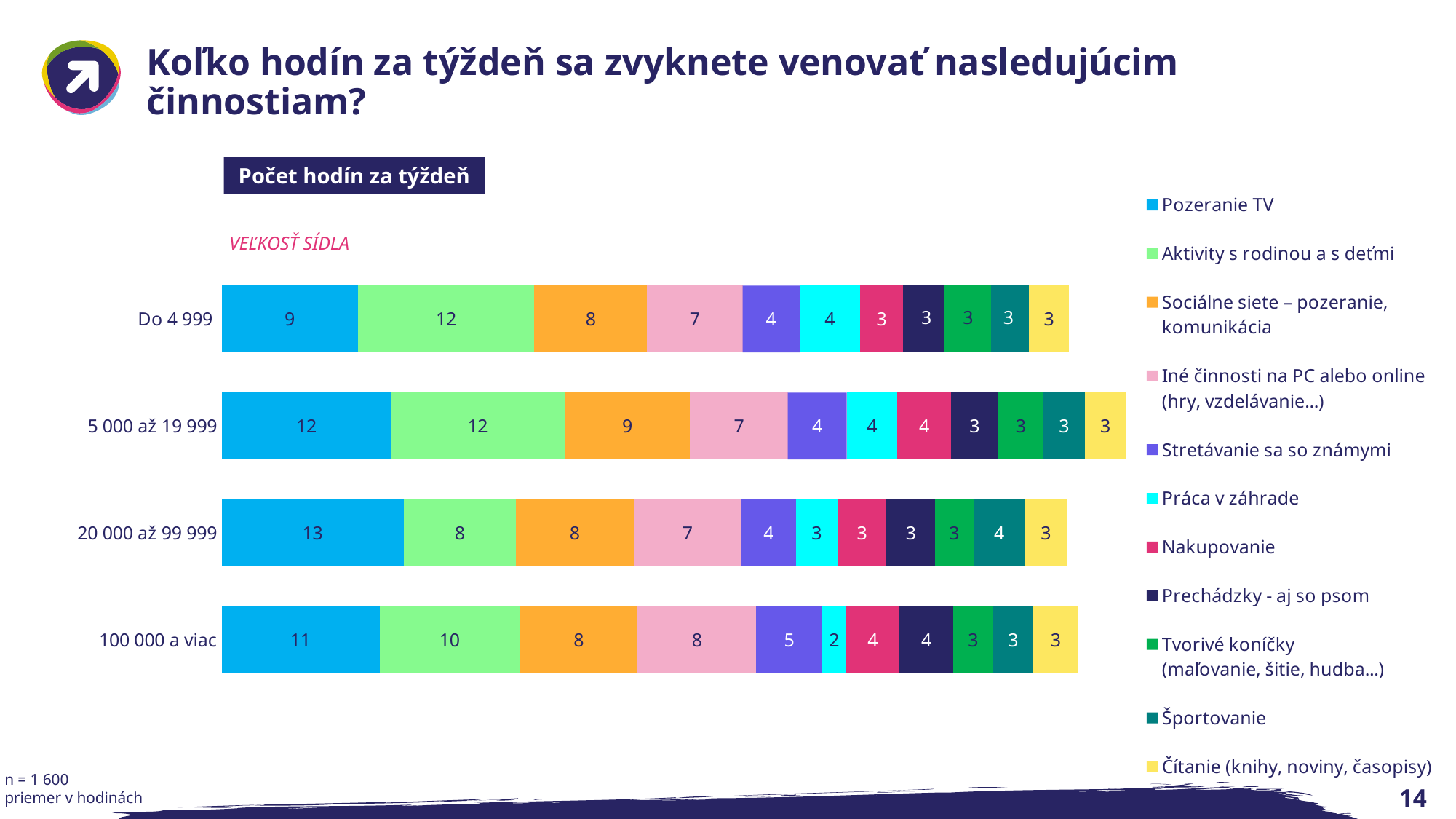
What is the title shown in the box above the chart? Počet hodín za týždeň What is the value for Pozeranie TV in the 20 000 až 99 999 category? 13 What is the total of the stacked bar for 5 000 až 19 999? 64 What is the value for Aktivity s rodinou a s deťmi in the Do 4 999 category? 12 How many settlement-size categories are shown on the chart? 4 Which settlement-size category has the lowest value for Pozeranie TV? Do 4 999 Which is larger: Aktivity s rodinou a s deťmi for 5 000 až 19 999 or for 20 000 až 99 999? 5 000 až 19 999 What type of chart is shown on the slide? stacked bar chart What is the difference between the Pozeranie TV values for 20 000 až 99 999 and Do 4 999? 4 How many series does the legend list? 11 Which settlement-size category has the highest value for Pozeranie TV? 20 000 až 99 999 What is the value for Práca v záhrade in the 100 000 a viac category? 2